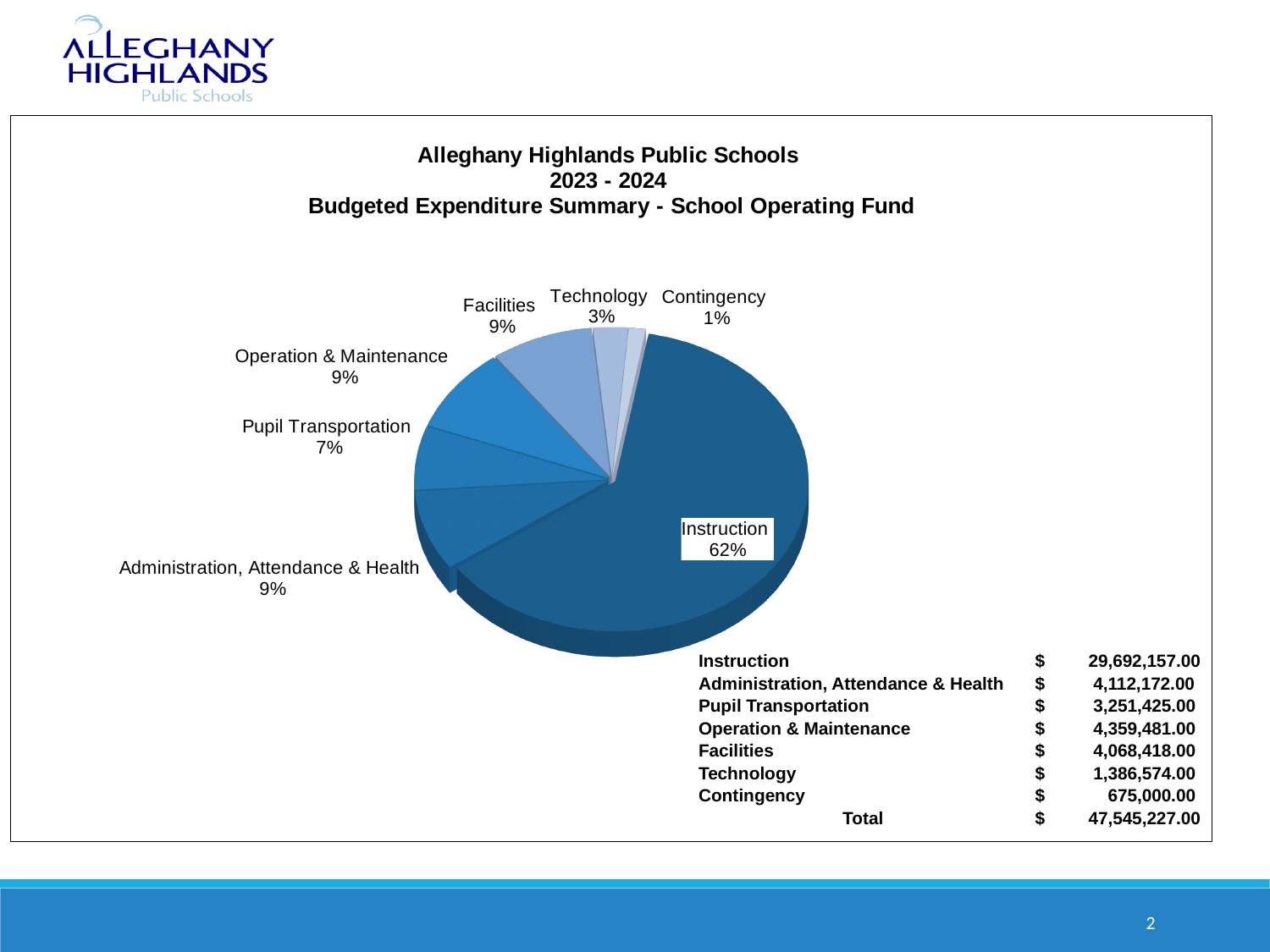
What is the difference in percentage points between the Instruction share and the Facilities share? 53 What is the total budgeted expenditure shown on the slide? $ 47,545,227.00 How many categories are shown in the pie chart? 7 What share of the pie does Instruction represent? 62% What share of the pie does Technology represent? 3% Which is larger, the share for Pupil Transportation or the share for Facilities? Facilities What kind of chart is shown on the slide? Pie chart What is the budgeted amount for Operation & Maintenance shown in the table below the chart? $ 4,359,481.00 Which category has the smallest slice of the pie? Contingency What share of the pie does Pupil Transportation represent? 7% Which category has the largest slice of the pie? Instruction What is the title of the chart? Alleghany Highlands Public Schools 2023 - 2024 Budgeted Expenditure Summary - School Operating Fund